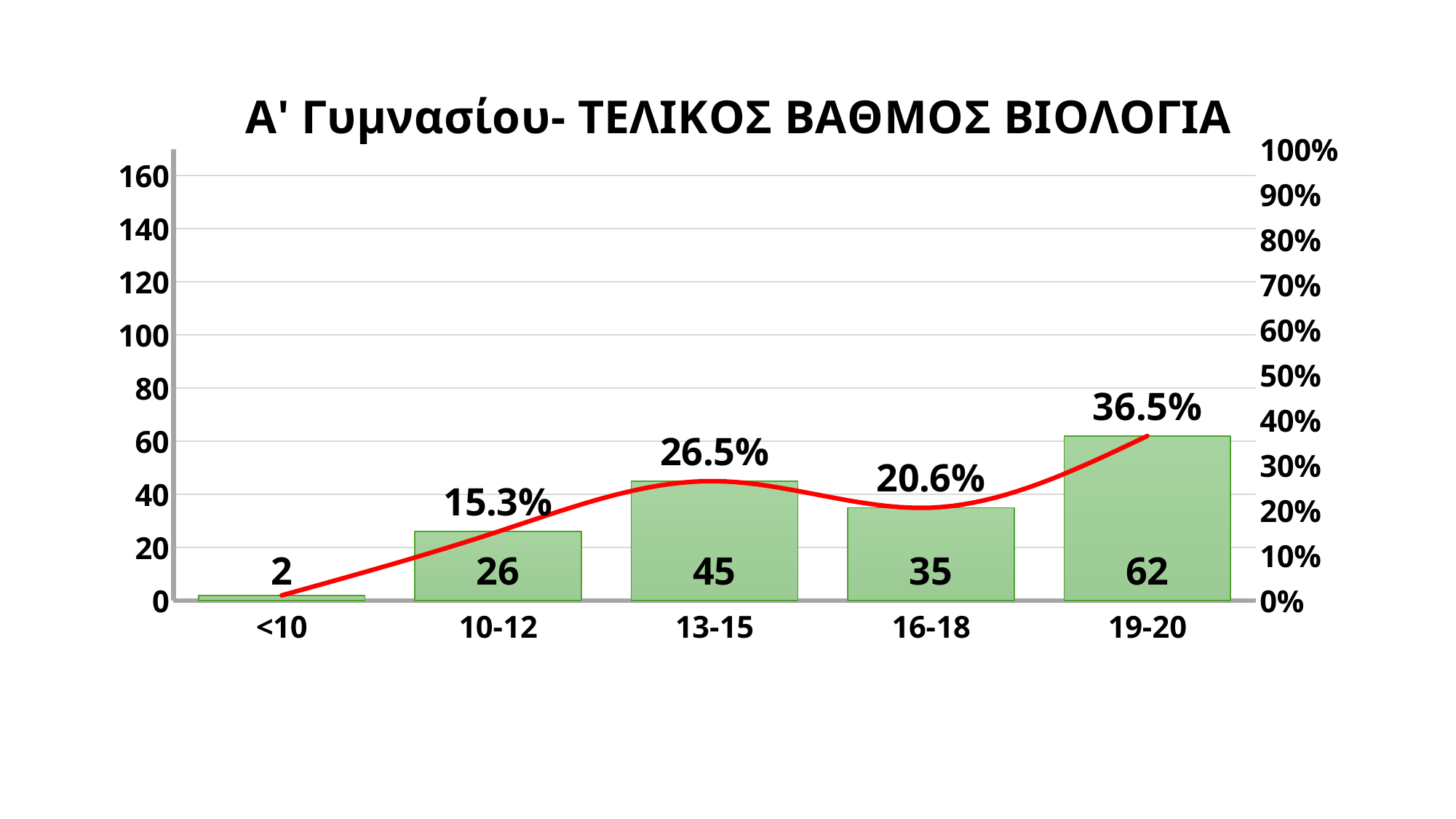
What is the bar value for the 13-15 category? 45 Is the bar value for 19-20 greater or less than 80 on the left axis? less What is the difference between the bar values for 19-20 and 16-18? 27 Which has a larger bar value, 13-15 or 16-18? 13-15 What percentage is shown on the line for the 16-18 category? 20.6% Which category has the highest bar value? 19-20 Which category has the lowest bar value? <10 What is the title of the chart? Α' Γυμνασίου- ΤΕΛΙΚΟΣ ΒΑΘΜΟΣ ΒΙΟΛΟΓΙΑ What kind of chart is this? Combined bar and line chart What percentage is shown on the line for the 10-12 category? 15.3% How many categories are shown on the x axis? 5 What is the bar value for the 19-20 category? 62